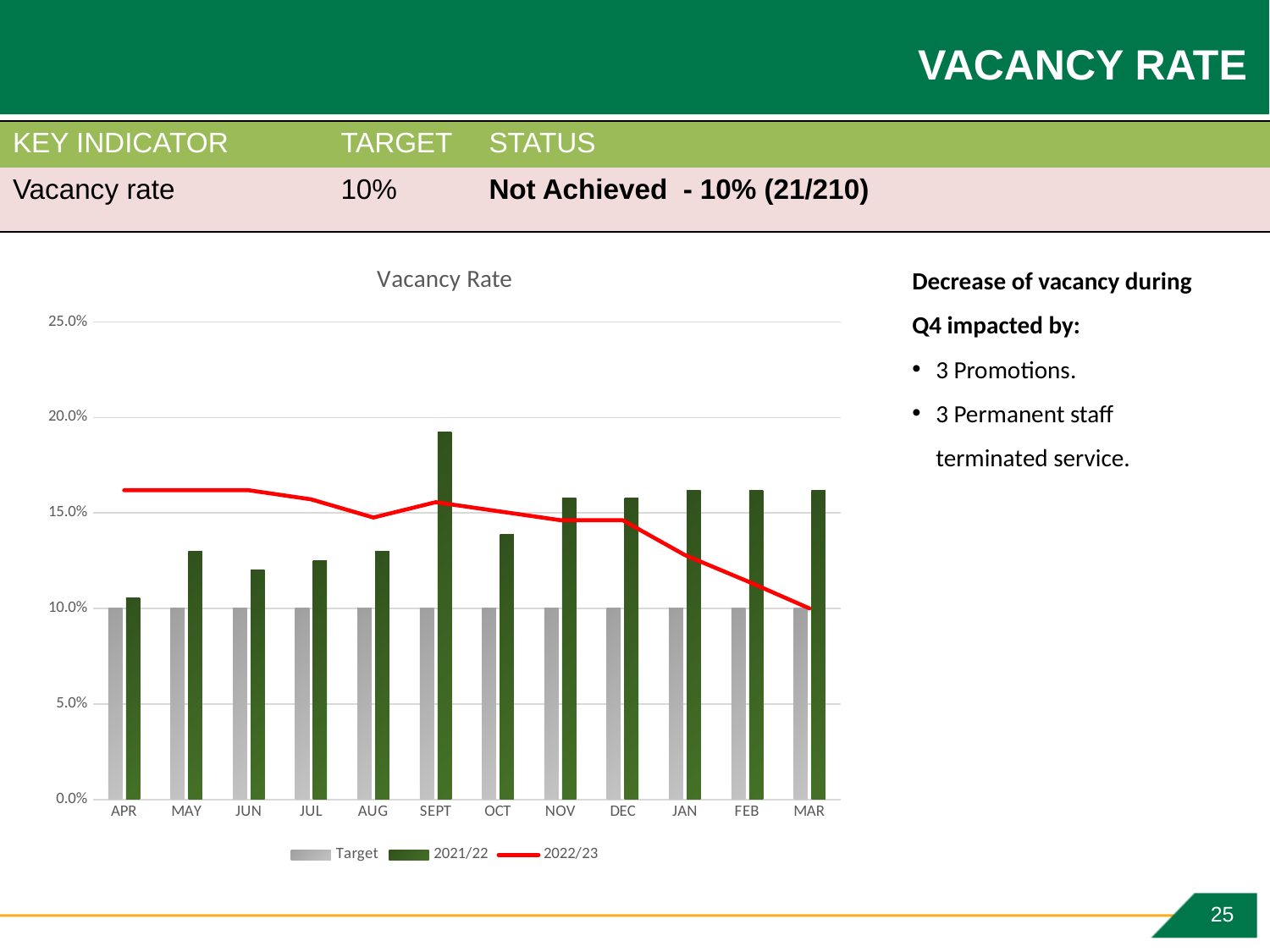
Which month has the highest 2021/22 value in the chart? SEPT Does the 2022/23 line rise or fall overall from APR to MAR? fall Which month has the lowest 2021/22 value in the chart? APR Which series in the chart is drawn as a red line? 2022/23 Is the 2022/23 value for APR greater or less than 15.0%? greater Is the 2021/22 value for SEPT greater or less than 15.0%? greater How many series does the chart legend list? 3 Is the 2021/22 value for JUN greater or less than 15.0%? less Which is larger in the chart: the 2021/22 value for SEPT or for MAY? SEPT What is the Target value shown for each month in the chart? 10.0% What is the title of the chart? Vacancy Rate How many months are shown on the x axis of the chart? 12